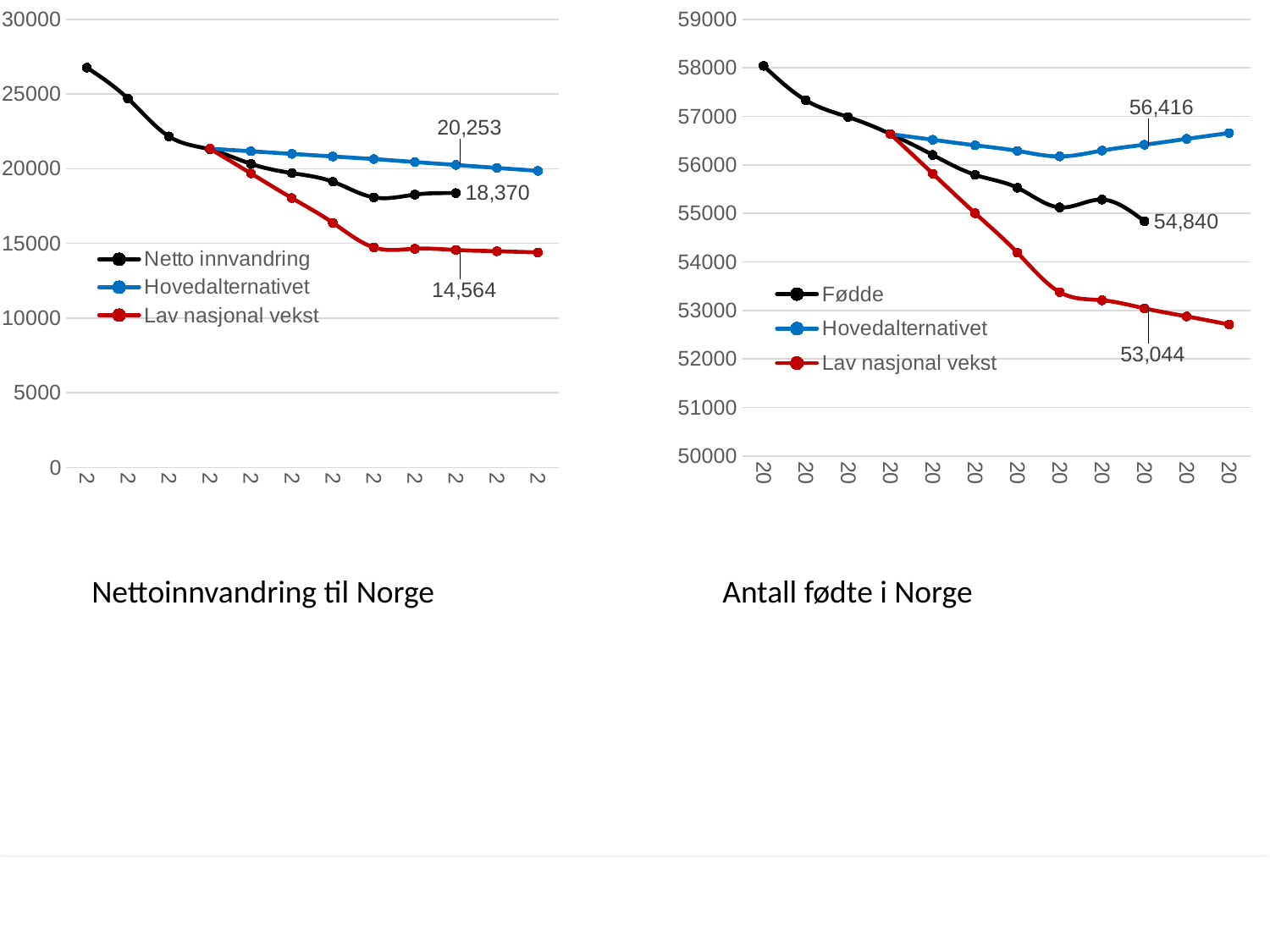
In the right chart, Antall fødte i Norge, what is the labelled value on the Hovedalternativet line? 56,416 In the right chart, Antall fødte i Norge, is the first value of the Fødde line greater or less than 57000? greater In the left chart, Nettoinnvandring til Norge, what is the labelled value on the Hovedalternativet line? 20,253 In the left chart, Nettoinnvandring til Norge, does the Lav nasjonal vekst line rise or fall along the x axis? fall In the right chart, Antall fødte i Norge, how many series does the legend list? 3 In the right chart, Antall fødte i Norge, which labelled value is larger: Fødde or Lav nasjonal vekst? Fødde In the left chart, Nettoinnvandring til Norge, what is the difference between the labelled Hovedalternativet value (20,253) and the labelled Lav nasjonal vekst value (14,564)? 5,689 In the left chart, Nettoinnvandring til Norge, what is the labelled value on the Lav nasjonal vekst line? 14,564 In the left chart, Nettoinnvandring til Norge, how many series does the legend list? 3 In the right chart, Antall fødte i Norge, what is the difference between the labelled Hovedalternativet value (56,416) and the labelled Lav nasjonal vekst value (53,044)? 3,372 In the right chart, Antall fødte i Norge, what is the labelled value on the Fødde line? 54,840 What kind of chart is the left chart, Nettoinnvandring til Norge? line chart